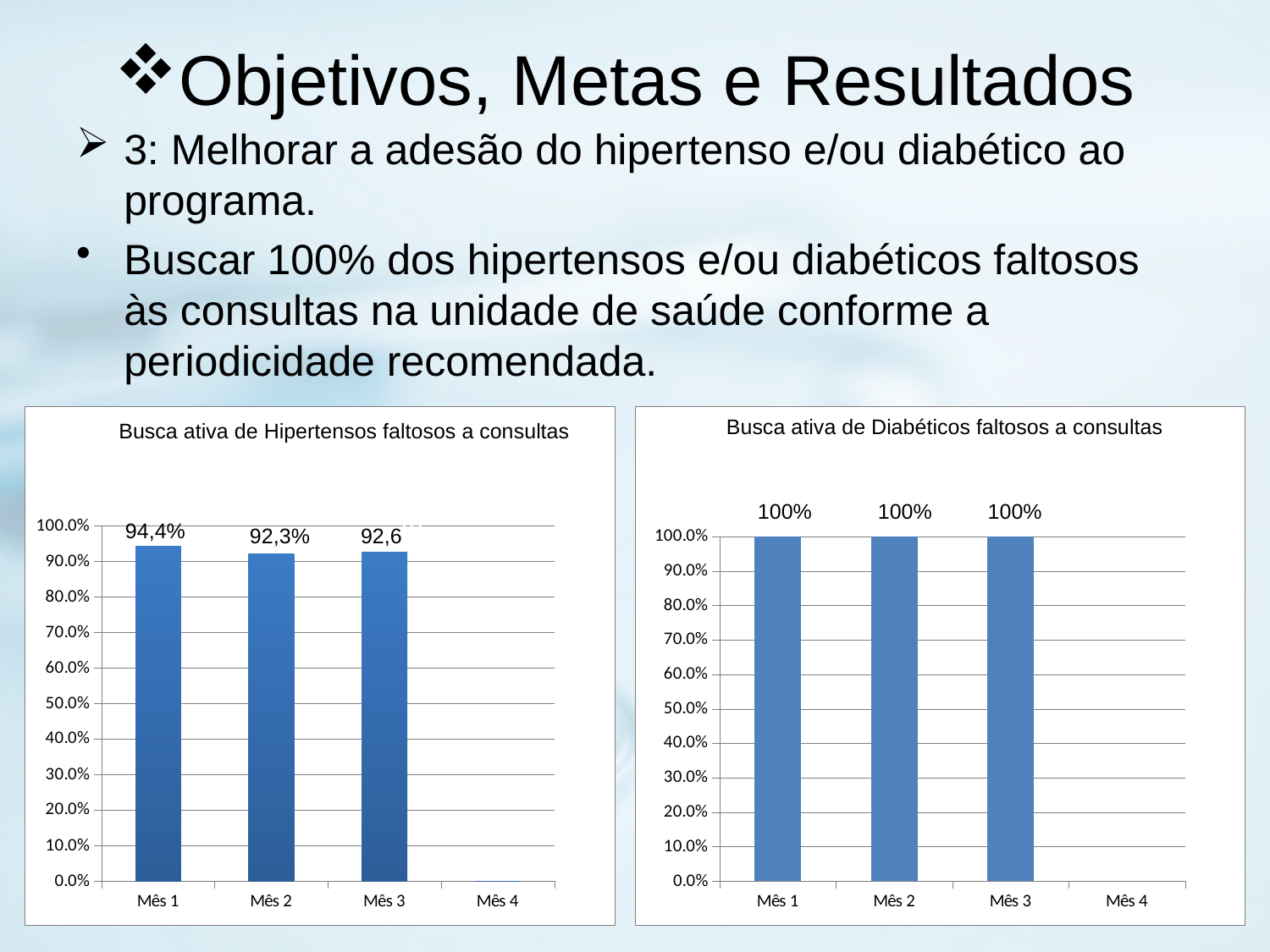
In the chart titled 'Busca ativa de Diabéticos faltosos a consultas', what is the value for Mês 2? 100% In the chart titled 'Busca ativa de Hipertensos faltosos a consultas', what is the difference between the values for Mês 1 and Mês 2? 2,1% In the chart titled 'Busca ativa de Diabéticos faltosos a consultas', do the values change from Mês 1 to Mês 3? No, they stay at 100% In the chart titled 'Busca ativa de Hipertensos faltosos a consultas', which month has the highest value? Mês 1 In the chart titled 'Busca ativa de Hipertensos faltosos a consultas', what is the value for Mês 2? 92,3% Which is larger: the value for Mês 1 in the 'Busca ativa de Diabéticos faltosos a consultas' chart or the value for Mês 1 in the 'Busca ativa de Hipertensos faltosos a consultas' chart? Mês 1 in the Diabéticos chart (100%) What is the title of the chart on the left of the slide? Busca ativa de Hipertensos faltosos a consultas In the chart titled 'Busca ativa de Hipertensos faltosos a consultas', what is the value for Mês 1? 94,4% In the chart titled 'Busca ativa de Hipertensos faltosos a consultas', is the value for Mês 3 greater or less than 90.0%? greater In the chart titled 'Busca ativa de Hipertensos faltosos a consultas', how many months are labelled on the x axis? 4 In the chart titled 'Busca ativa de Diabéticos faltosos a consultas', what is the value for Mês 3? 100% What kind of chart is the chart titled 'Busca ativa de Diabéticos faltosos a consultas'? Bar chart